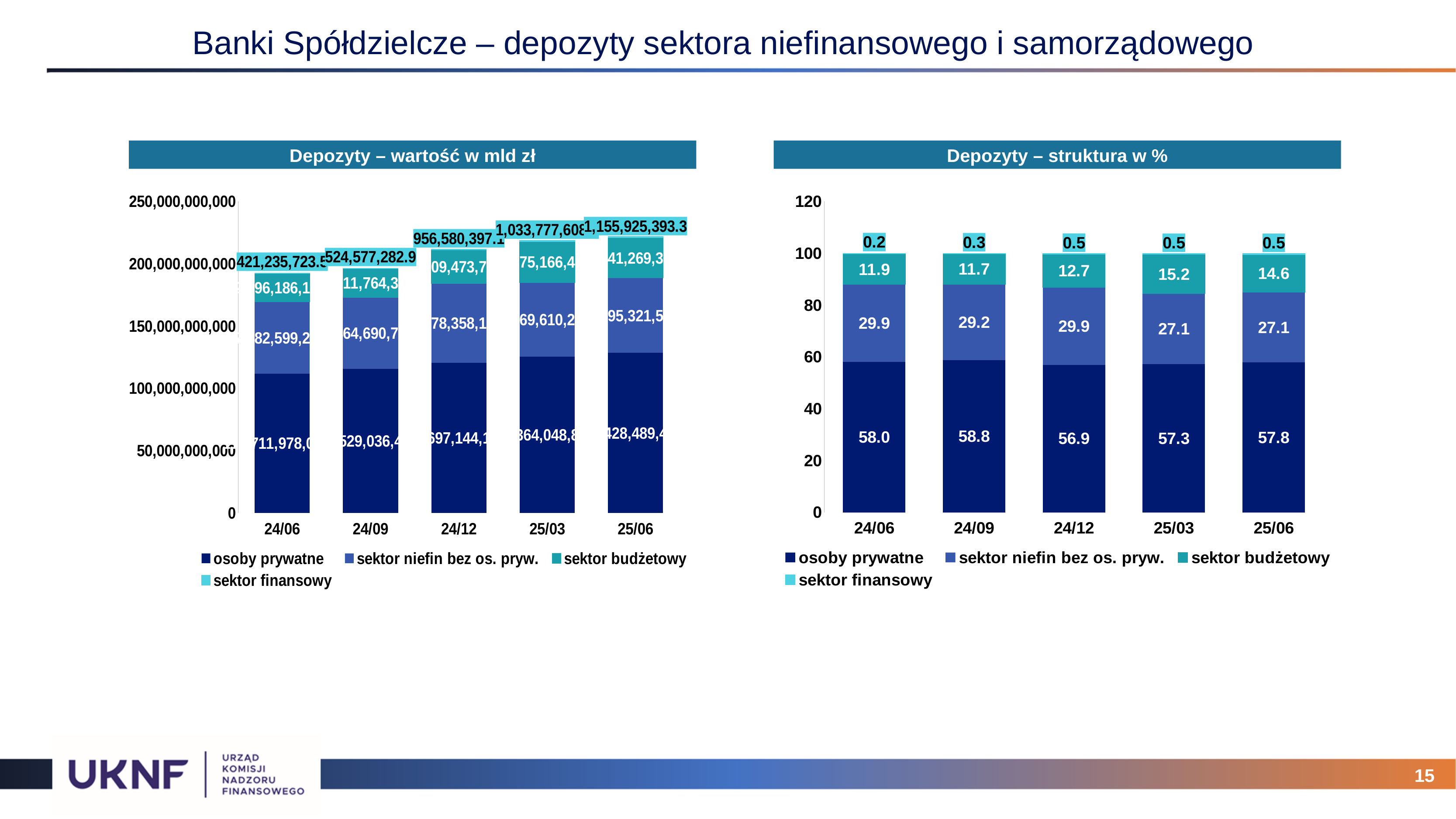
In the 'Depozyty – struktura w %' chart, in which period is the share of sektor budżetowy lowest? 24/09 In the 'Depozyty – struktura w %' chart, what is the difference between the sektor niefin bez os. pryw. values at 24/06 and 25/06? 2.8 In the 'Depozyty – wartość w mld zł' chart, is the total height of the 25/06 bar greater or less than 200,000,000,000? greater In the 'Depozyty – struktura w %' chart, what is the value for osoby prywatne at 24/12? 56.9 In the 'Depozyty – struktura w %' chart, how many periods are shown on the x axis? 5 In the 'Depozyty – wartość w mld zł' chart, what is the value for sektor finansowy at 24/06? 421,235,723.5 In the 'Depozyty – wartość w mld zł' chart, do the sektor finansowy values rise or fall from 24/06 to 25/06? Rise In the 'Depozyty – struktura w %' chart, in which period is the share of osoby prywatne highest? 24/09 In the 'Depozyty – wartość w mld zł' chart, how many series does the legend list? 4 In the 'Depozyty – struktura w %' chart, which period has the larger sektor budżetowy share, 24/12 or 25/06? 25/06 What kind of chart is the 'Depozyty – struktura w %' chart? Stacked bar chart In the 'Depozyty – struktura w %' chart, what is the value for sektor budżetowy at 25/03? 15.2